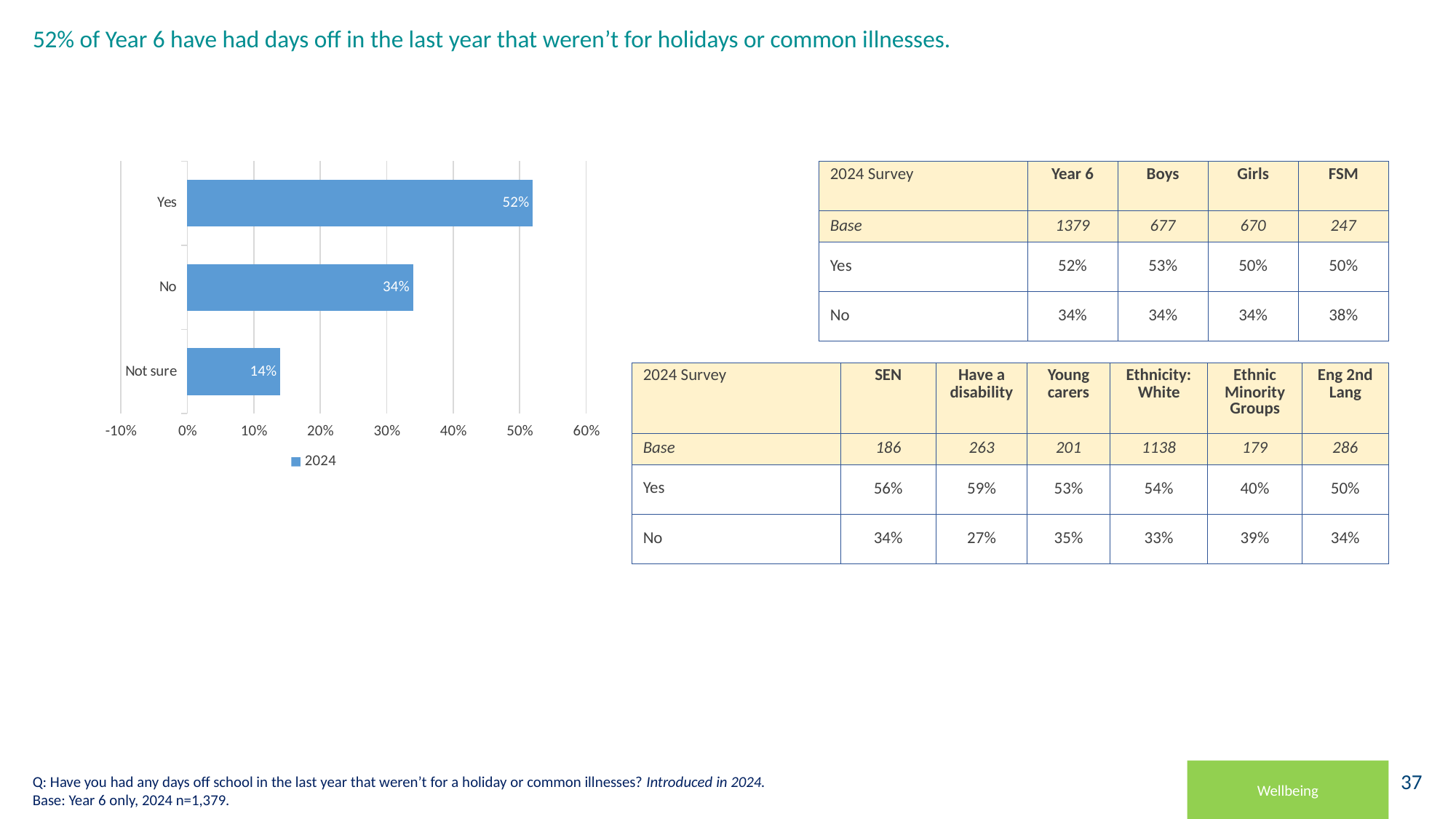
How many series does the legend of the bar chart list? 1 Is the value for Yes in the bar chart greater or less than 50%? greater Which is larger in the bar chart, the value for No or the value for Not sure? No What is the value for No in the bar chart? 34% What is the value for Yes in the bar chart? 52% Which category has the highest value in the bar chart? Yes What is the difference between the No and Not sure values in the bar chart? 20% How many categories are shown in the bar chart? 3 What is the value for Not sure in the bar chart? 14% What is the difference between the Yes and No values in the bar chart? 18% Which category has the lowest value in the bar chart? Not sure What kind of chart is shown on the slide? Bar chart